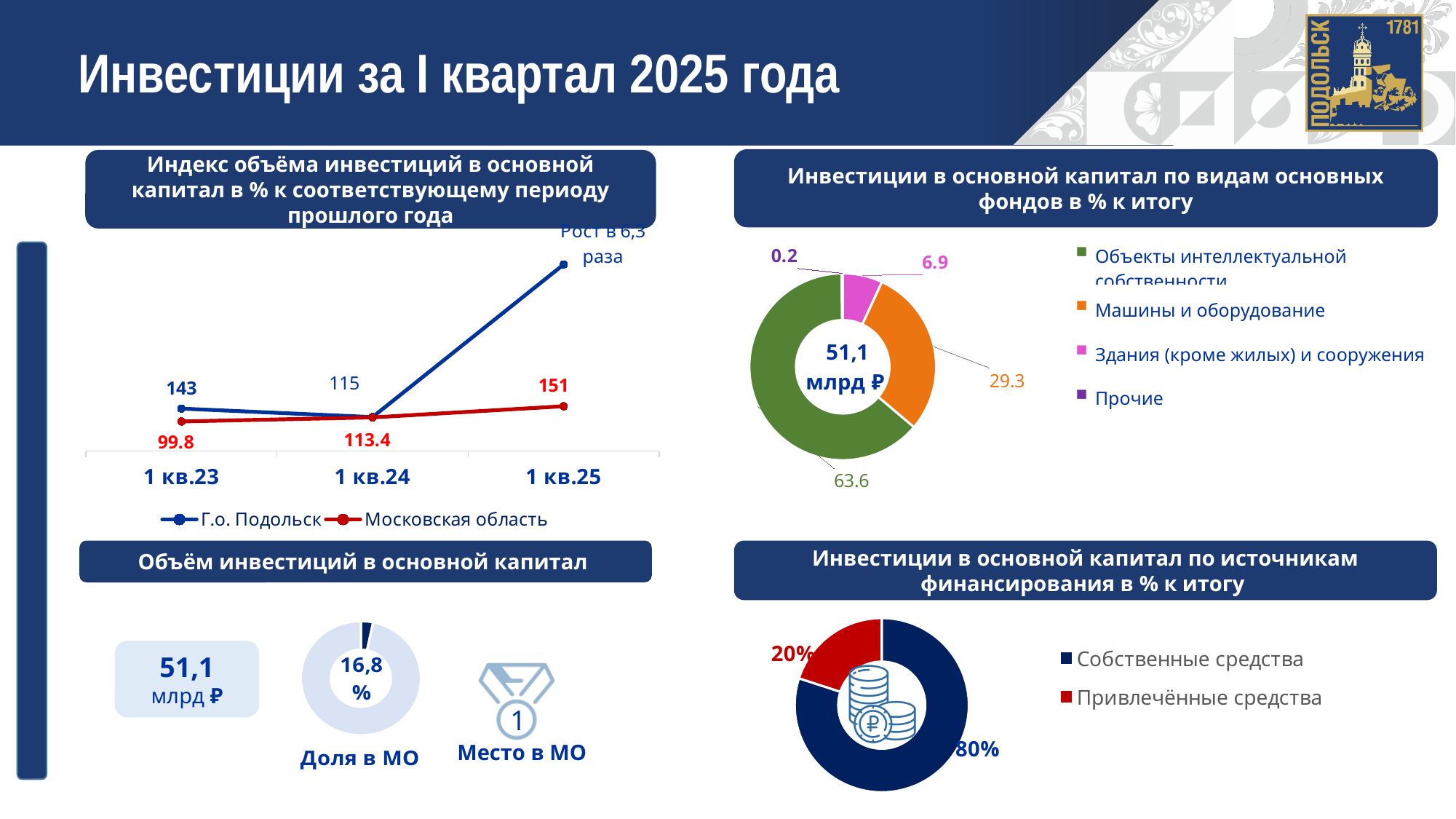
In the donut chart 'Инвестиции в основной капитал по видам основных фондов', how many categories does the legend list? 4 In the line chart 'Индекс объёма инвестиций в основной капитал', what is the value for Г.о. Подольск in 1 кв.23? 143 In the line chart 'Индекс объёма инвестиций в основной капитал', what is the difference between the Г.о. Подольск and Московская область values in 1 кв.23? 43.2 In the donut chart 'Инвестиции в основной капитал по видам основных фондов', which category has the smallest share? Прочие In the donut chart 'Инвестиции в основной капитал по источникам финансирования', what is the share for Привлечённые средства? 20% In the line chart 'Индекс объёма инвестиций в основной капитал', what is the value for Московская область in 1 кв.24? 113.4 In the donut chart 'Инвестиции в основной капитал по источникам финансирования', which is larger: Собственные средства or Привлечённые средства? Собственные средства In the line chart 'Индекс объёма инвестиций в основной капитал', what is the value for Московская область in 1 кв.25? 151 In the donut chart 'Инвестиции в основной капитал по видам основных фондов', what is the share for Машины и оборудование? 29.3 In the line chart 'Индекс объёма инвестиций в основной капитал', does the Московская область series rise or fall from 1 кв.23 to 1 кв.25? rise In the donut chart 'Инвестиции в основной капитал по видам основных фондов', which category has the largest share? Объекты интеллектуальной собственности In the line chart 'Индекс объёма инвестиций в основной капитал', how many series does the legend list? 2